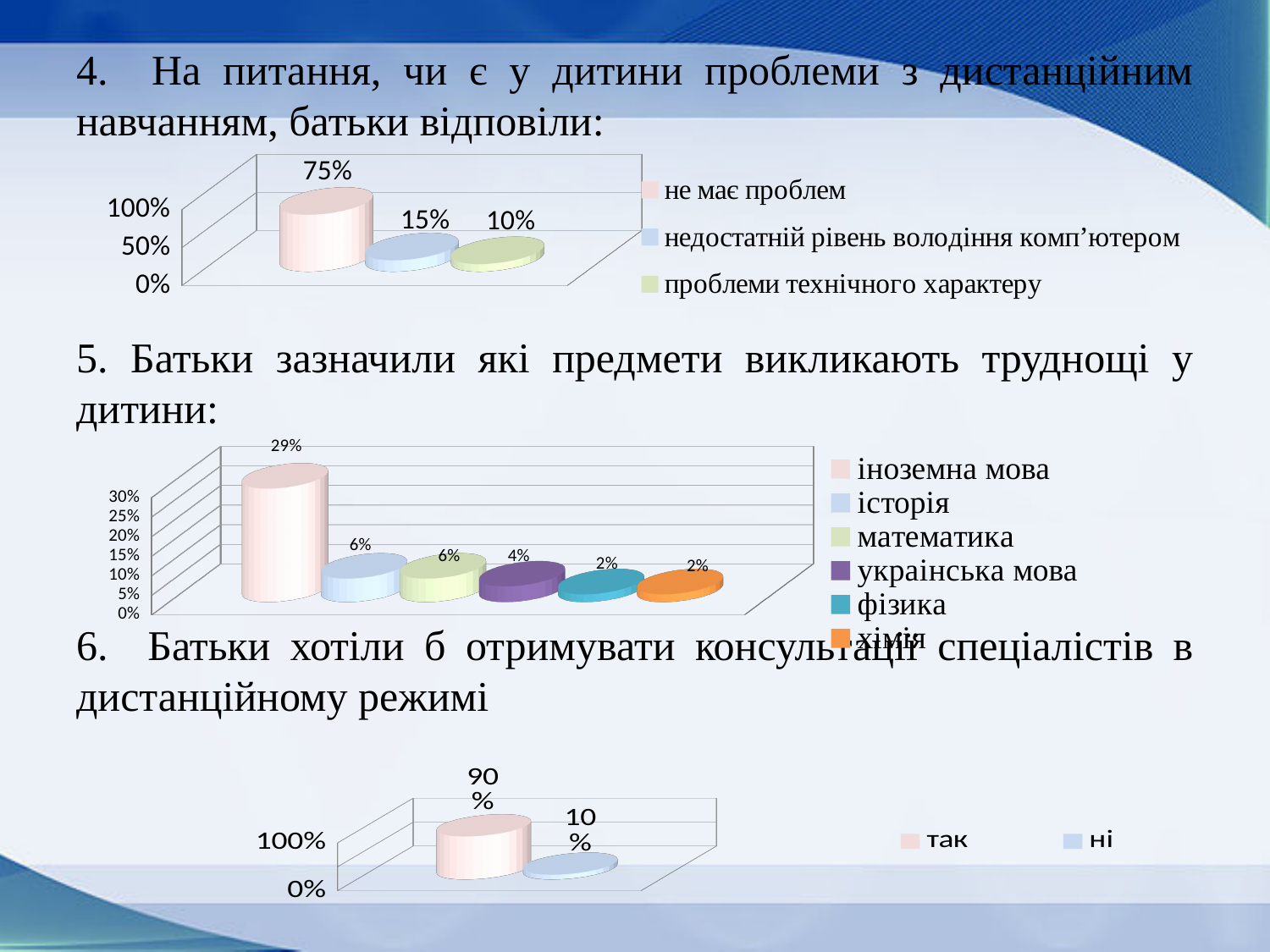
In the middle chart (question 5), which subject has the highest value? іноземна мова In the top chart (question 4), what is the value for "проблеми технічного характеру"? 10% In the top chart (question 4), how many series does the legend list? 3 In the top chart (question 4), what percentage of parents answered "не має проблем"? 75% In the middle chart (question 5), what is the value for "українська мова"? 4% In the bottom chart (question 6), what percentage of parents answered "так"? 90% In the middle chart (question 5), is the value for "іноземна мова" greater or less than 25%? greater In the middle chart (question 5), how many subjects are plotted? 6 In the top chart (question 4), what is the difference between "не має проблем" and "недостатній рівень володіння комп’ютером"? 60% In the middle chart (question 5), what is the value for "історія"? 6% What kind of chart is the bottom chart (question 6)? bar chart In the bottom chart (question 6), which is larger, "так" or "ні"? так